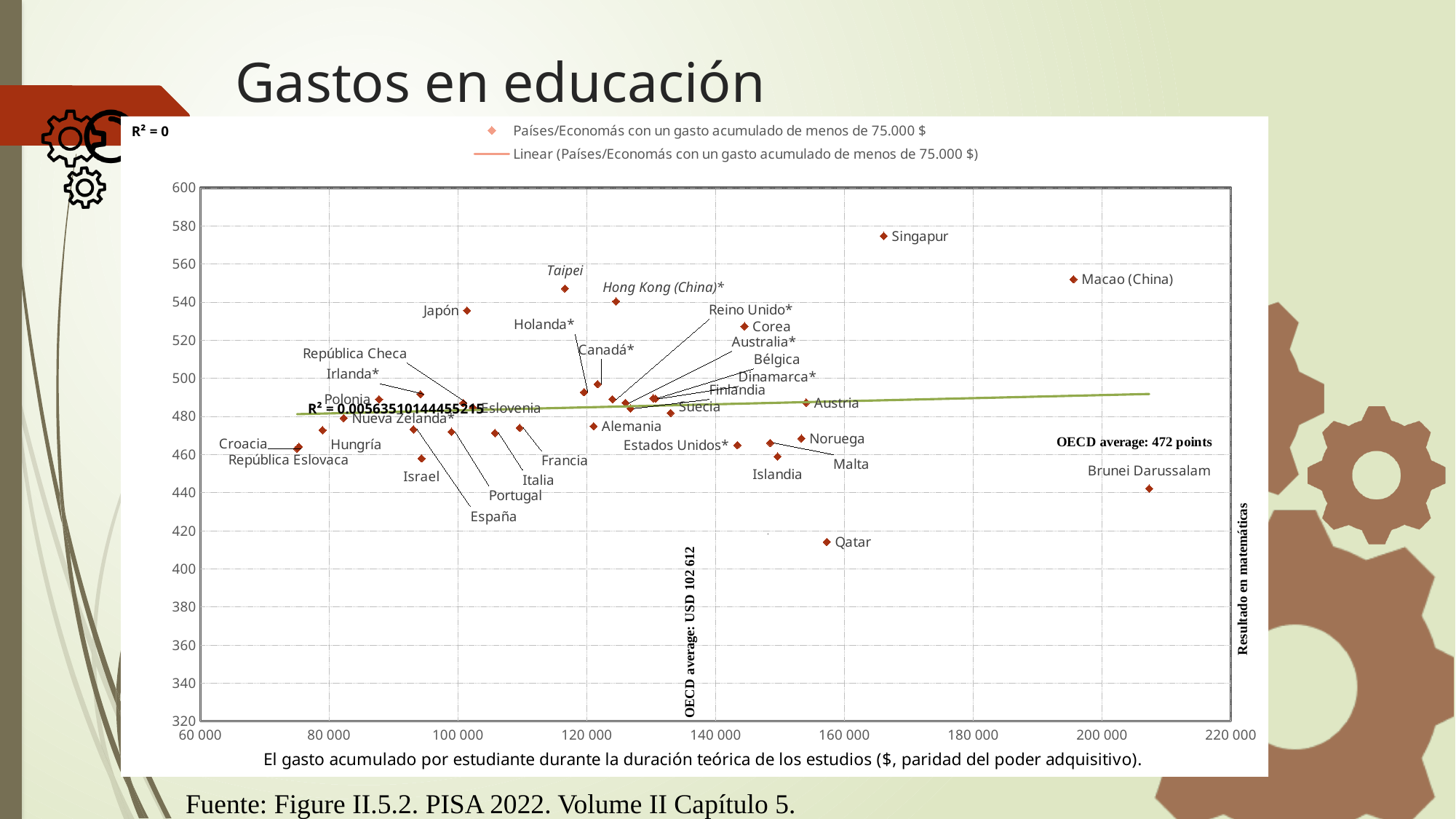
Which country/economy has the lowest mathematics result in the chart? Qatar Is the mathematics result for Qatar greater or less than 440? less Does the linear trend line rise or fall as cumulative spending increases along the x axis? rises What OECD average mathematics score is noted on the chart? 472 points Which has a higher mathematics result, Qatar or Brunei Darussalam? Brunei Darussalam Is the mathematics result for Japón greater or less than 520? greater How many entries does the chart legend list? 2 Is the mathematics result for Singapur greater or less than 560? greater Which has a higher mathematics result, Singapur or Macao (China)? Singapur What kind of chart is shown on the slide? scatter plot Which country/economy has the highest mathematics result in the chart? Singapur